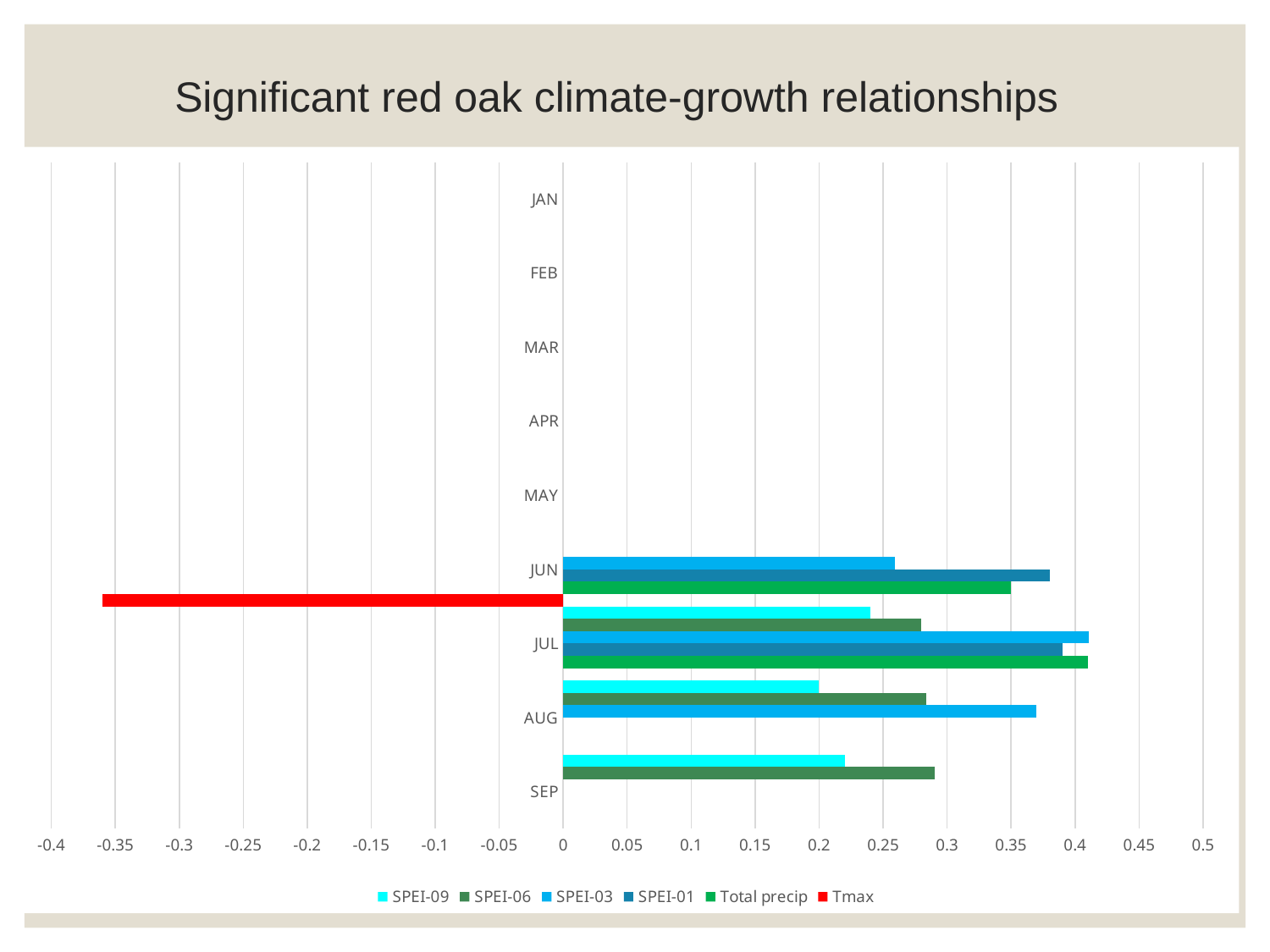
Is the Tmax value for JUN greater or less than -0.3? less Is the SPEI-03 value for JUN greater or less than 0.3? less In AUG, which is larger: the SPEI-03 value or the SPEI-09 value? SPEI-03 What is the title of the chart? Significant red oak climate-growth relationships In JUN, which is larger: the SPEI-01 value or the SPEI-03 value? SPEI-01 Is the SPEI-01 value for JUN greater or less than 0.35? greater What kind of chart is shown on the slide? bar chart How many month categories are shown on the vertical axis? 9 How many series does the legend list? 6 Which series is the only one with a negative value? Tmax